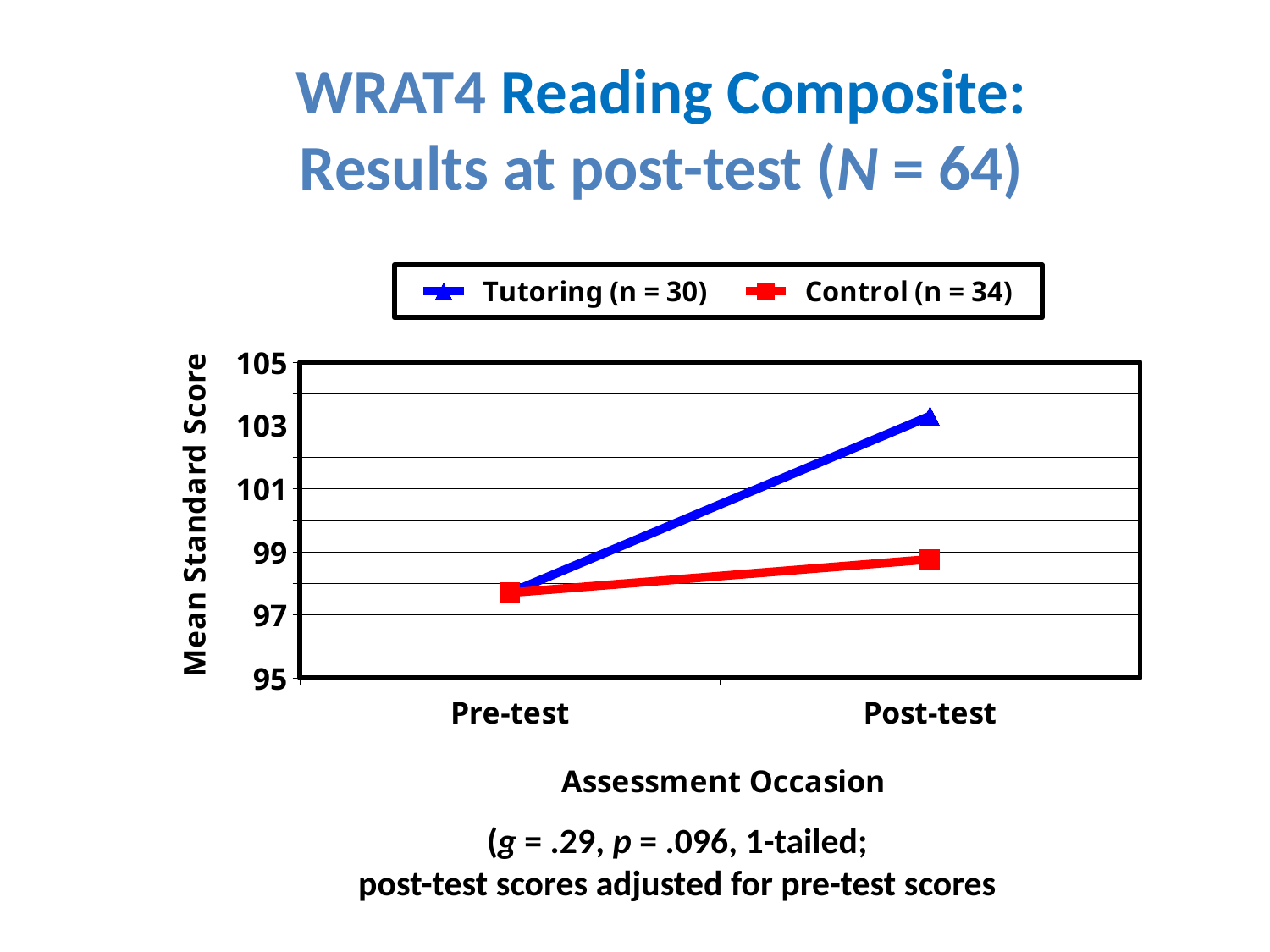
Is the Pre-test value for Control (n = 34) greater or less than 97? greater What is the title of the y axis? Mean Standard Score How many series does the legend list? 2 Which colour is used for the Control (n = 34) line? red Does the Control (n = 34) line rise or fall from Pre-test to Post-test? rise Is the Pre-test value for Tutoring (n = 30) greater or less than 99? less How many assessment occasions are plotted along the x axis? 2 Is the Post-test value for Tutoring (n = 30) greater or less than 101? greater What kind of chart is shown on the slide? line chart Does the Tutoring (n = 30) line rise or fall from Pre-test to Post-test? rise At Post-test, which group has the higher mean standard score, Tutoring (n = 30) or Control (n = 34)? Tutoring (n = 30)